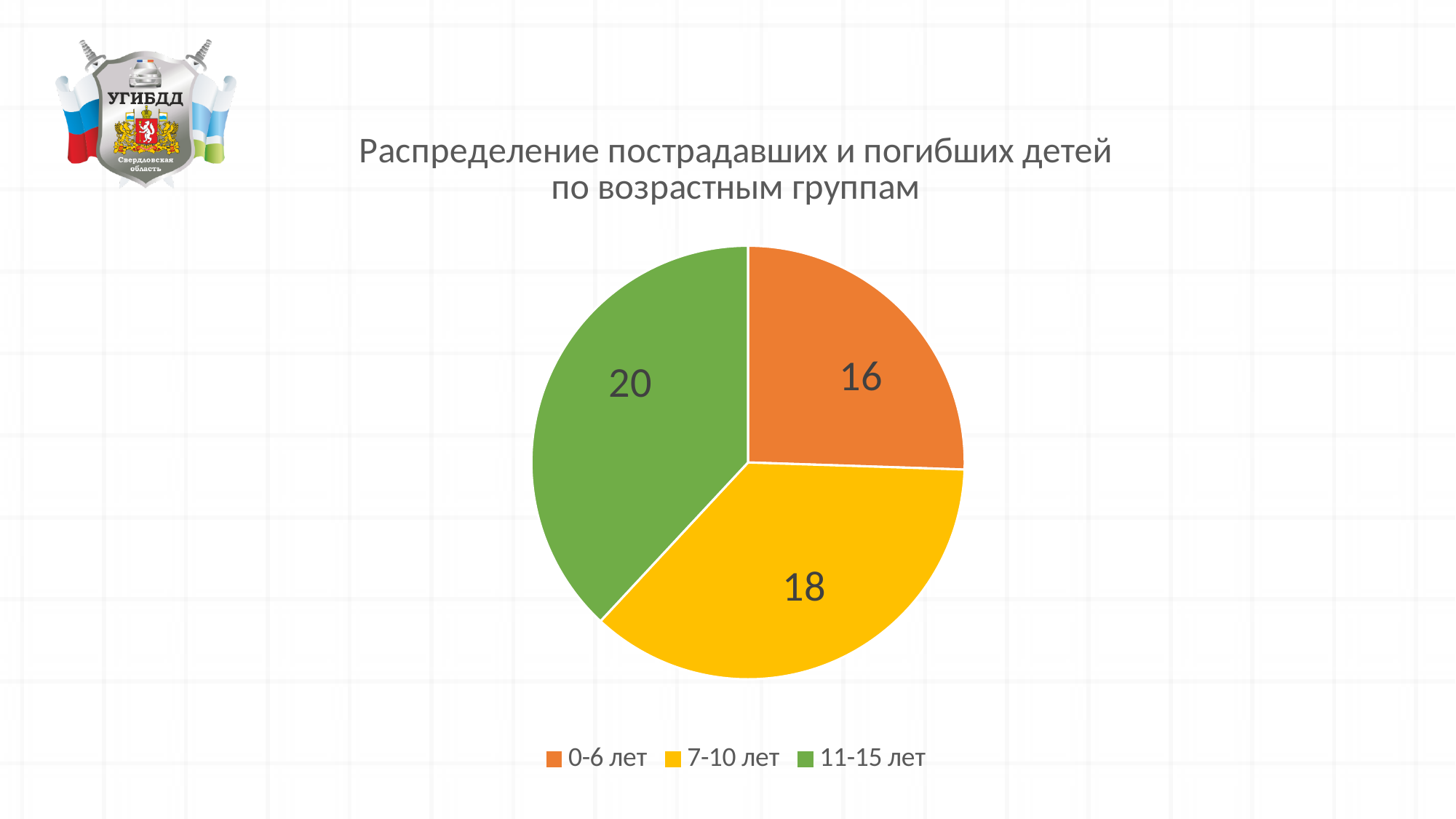
What is the value for the 0-6 лет slice? 16 What is the total of all slices in the pie chart? 54 What is the value for the 7-10 лет slice? 18 Which age group has the largest slice? 11-15 лет What is the title of the chart? Распределение пострадавших и погибших детей по возрастным группам What type of chart is shown on the slide? Pie chart How many slices does the pie chart have? 3 Which age group has the smallest slice? 0-6 лет What is the difference between the values for 11-15 лет and 0-6 лет? 4 Which is larger, the value for 7-10 лет or the value for 11-15 лет? 11-15 лет What is the value for the 11-15 лет slice? 20 What is the difference between the values for 7-10 лет and 0-6 лет? 2